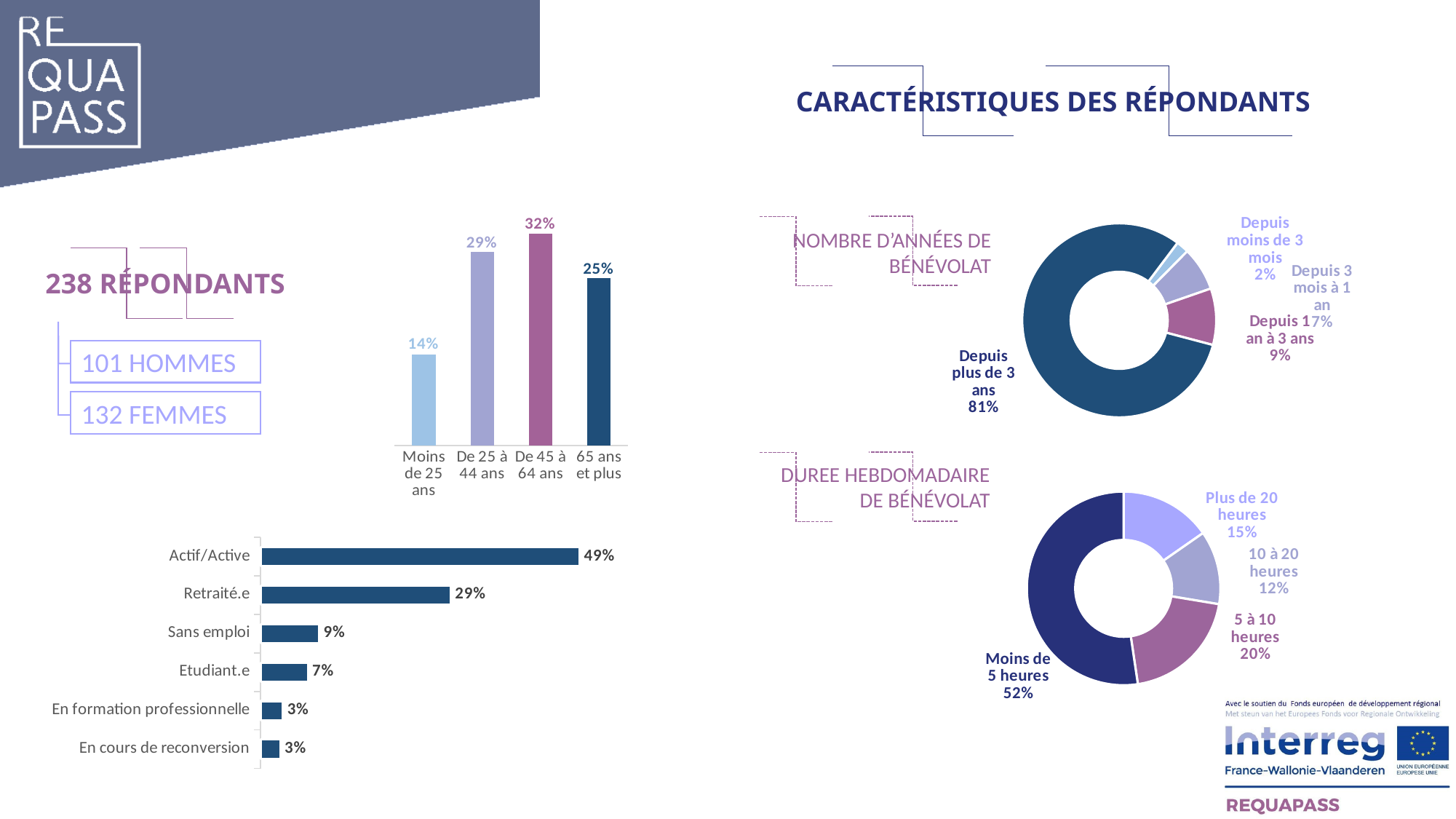
In the age bar chart at the top left, what is the difference between 'De 25 à 44 ans' and 'Moins de 25 ans'? 15% In the horizontal bar chart at the bottom left, which category has the highest value? Actif/Active In the age bar chart at the top left, what is the value for 'De 45 à 64 ans'? 32% In the 'Nombre d'années de bénévolat' chart, what share is 'Depuis plus de 3 ans'? 81% In the 'Durée hebdomadaire de bénévolat' chart, which category has the largest share? Moins de 5 heures In the horizontal bar chart at the bottom left, what is the value for 'Retraité.e'? 29% In the horizontal bar chart at the bottom left, how many categories are shown? 6 In the 'Durée hebdomadaire de bénévolat' chart, what share is '5 à 10 heures'? 20% In the age bar chart at the top left, how many age groups are shown? 4 In the horizontal bar chart at the bottom left, which is larger: 'Sans emploi' or 'Etudiant.e'? Sans emploi In the age bar chart at the top left, which age group has the lowest value? Moins de 25 ans What kind of chart is used for 'Nombre d'années de bénévolat'? Donut chart